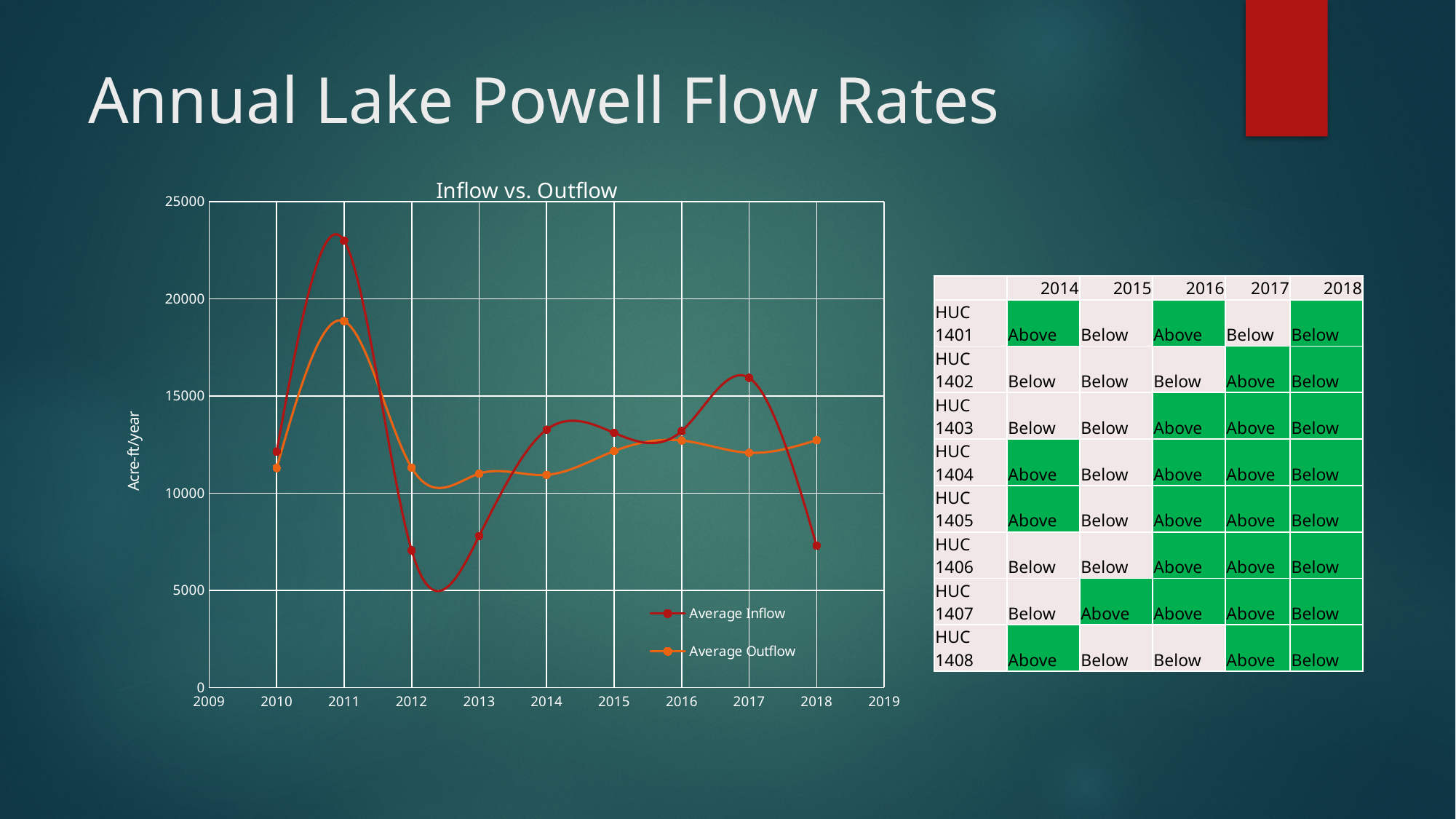
In the "Inflow vs. Outflow" chart, which is larger in 2011, Average Inflow or Average Outflow? Average Inflow In the "Inflow vs. Outflow" chart, which year has the highest Average Inflow? 2011 How many yearly data points are plotted for each series in the "Inflow vs. Outflow" chart? 9 How many series does the legend of the "Inflow vs. Outflow" chart list? 2 In the "Inflow vs. Outflow" chart, does the Average Inflow rise or fall from 2017 to 2018? fall What kind of chart is the "Inflow vs. Outflow" chart? line chart In the "Inflow vs. Outflow" chart, is the Average Outflow for 2011 greater or less than 15000? greater In the "Inflow vs. Outflow" chart, which is larger in 2018, Average Inflow or Average Outflow? Average Outflow In the "Inflow vs. Outflow" chart, is the Average Inflow for 2012 greater or less than 10000? less In the "Inflow vs. Outflow" chart, is the Average Inflow for 2011 greater or less than 20000? greater What are the two series named in the legend of the "Inflow vs. Outflow" chart? Average Inflow and Average Outflow In the "Inflow vs. Outflow" chart, which year has the highest Average Outflow? 2011